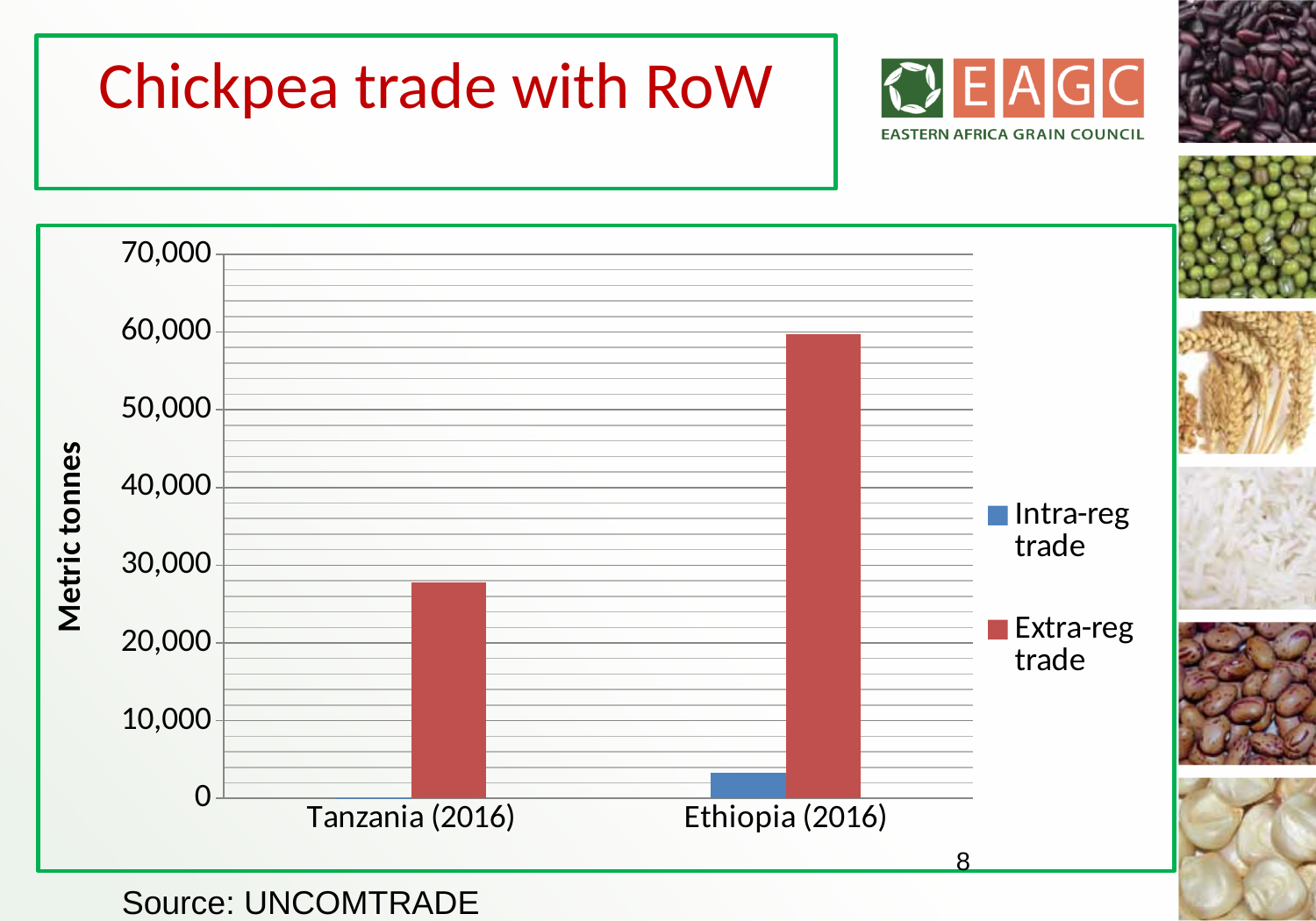
How many categories are shown on the x axis of the chart? 2 What type of chart is shown on the slide? Bar chart Which category has the lowest Extra-reg trade value? Tanzania (2016) Is the Extra-reg trade value for Ethiopia (2016) greater or less than 50,000? greater Is the Extra-reg trade value for Tanzania (2016) greater or less than 30,000? less Is the Extra-reg trade value for Tanzania (2016) greater or less than 20,000? greater Which category has the highest Extra-reg trade value? Ethiopia (2016) What is the label on the vertical axis of the chart? Metric tonnes How many series does the chart legend list? 2 For Ethiopia (2016), which is larger: Intra-reg trade or Extra-reg trade? Extra-reg trade What colour are the Extra-reg trade bars in the chart? Red